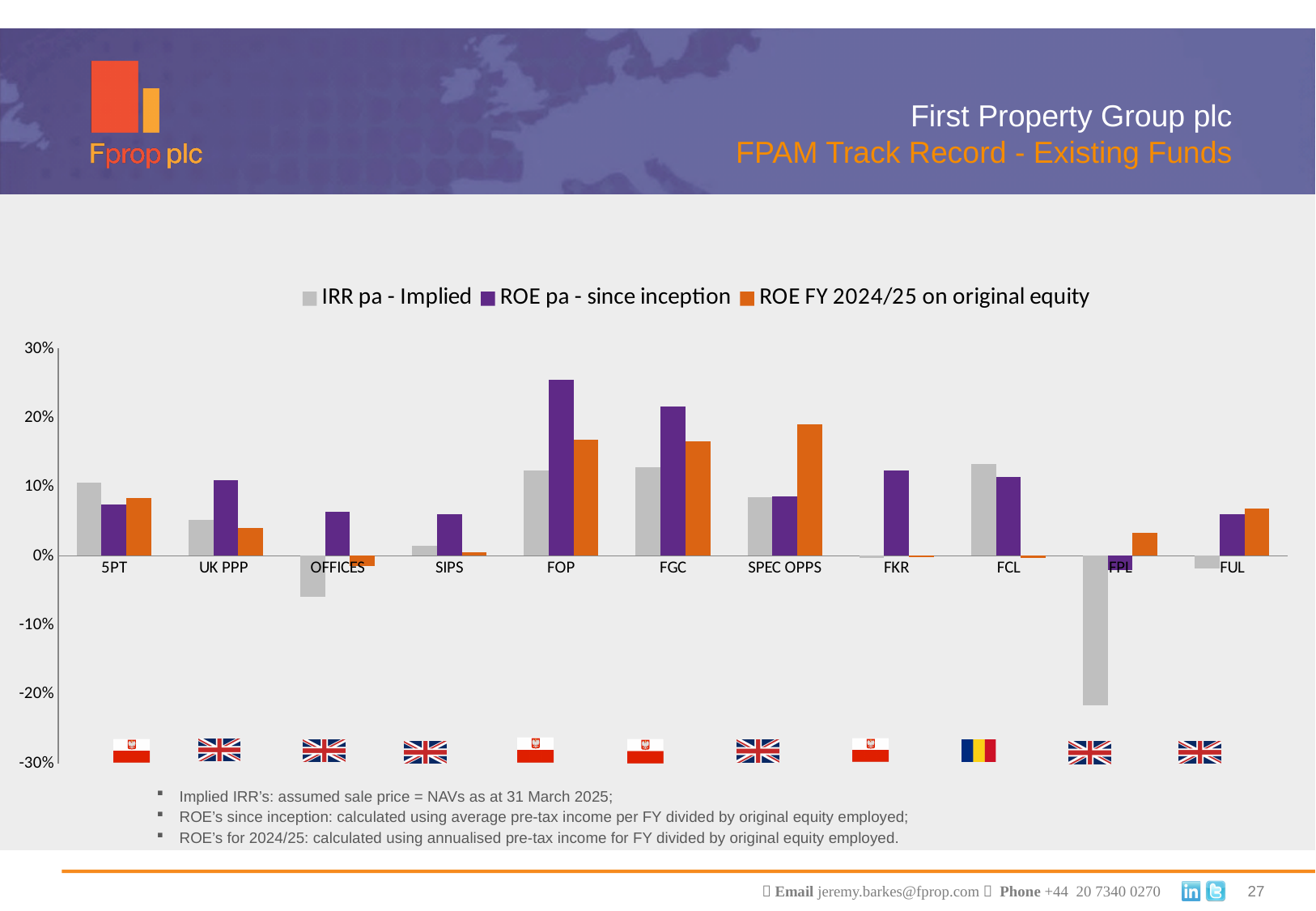
For FGC, which is larger: ROE pa - since inception or ROE FY 2024/25 on original equity? ROE pa - since inception Which fund has the highest ROE FY 2024/25 on original equity? SPEC OPPS What kind of chart is shown on the slide? bar chart Which fund has the lowest IRR pa - Implied? FPL How many series does the legend list? 3 For SPEC OPPS, which is larger: ROE pa - since inception or ROE FY 2024/25 on original equity? ROE FY 2024/25 on original equity Is the IRR pa - Implied for FPL greater or less than -10%? less Is the ROE FY 2024/25 on original equity for SPEC OPPS greater or less than 10%? greater Which fund has the highest ROE pa - since inception? FOP Which colour represents the IRR pa - Implied series in the legend? grey How many funds (categories) are shown along the x axis? 11 Is the ROE pa - since inception for FOP greater or less than 20%? greater